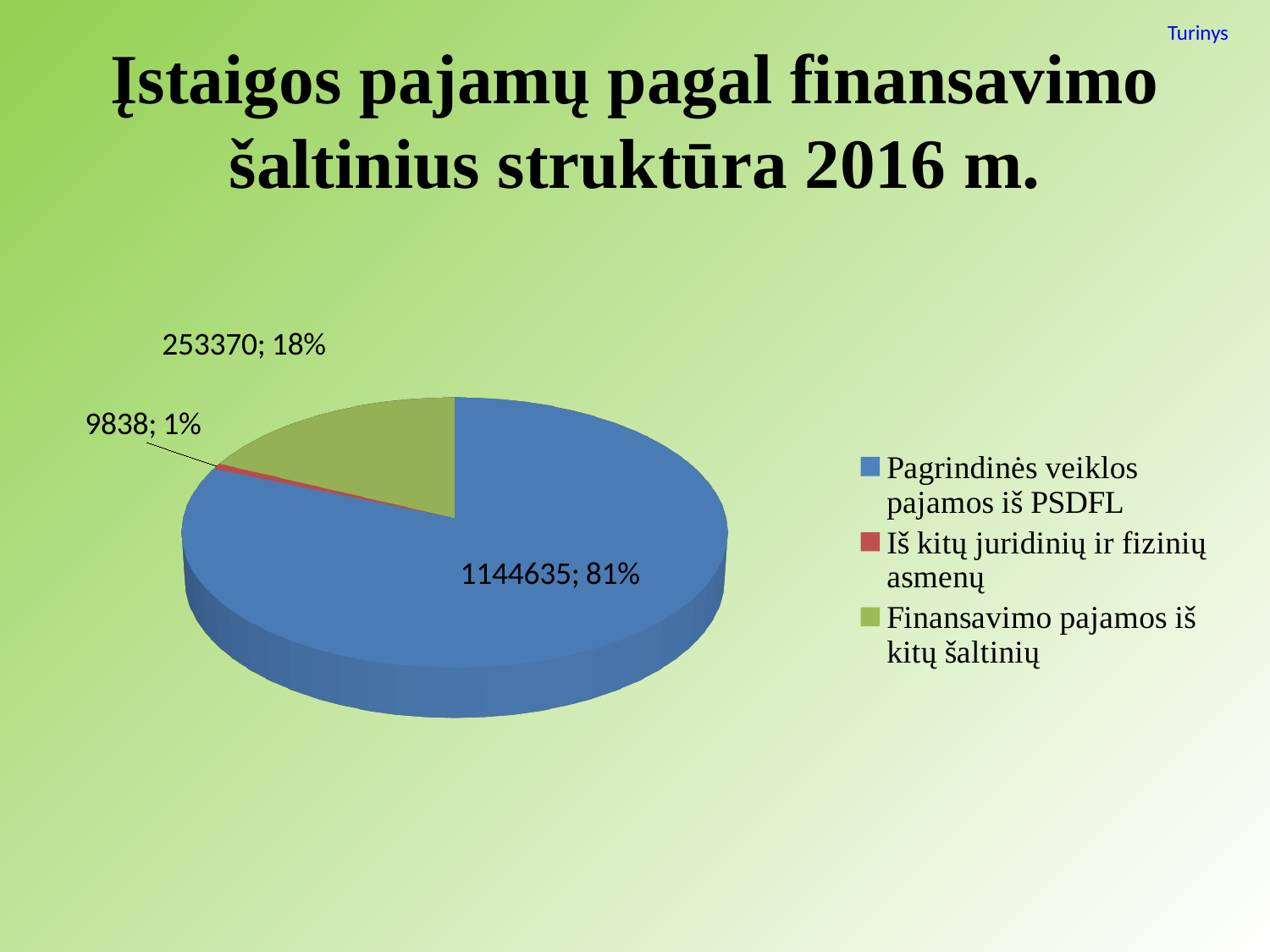
What colour is the slice for Finansavimo pajamos iš kitų šaltinių? green Which category has the smallest slice? Iš kitų juridinių ir fizinių asmenų What is the difference between the values for Finansavimo pajamos iš kitų šaltinių and Iš kitų juridinių ir fizinių asmenų? 243532 Which category has the largest slice? Pagrindinės veiklos pajamos iš PSDFL How many categories does the pie chart have? 3 Which is larger: Finansavimo pajamos iš kitų šaltinių or Iš kitų juridinių ir fizinių asmenų? Finansavimo pajamos iš kitų šaltinių What is the value for Iš kitų juridinių ir fizinių asmenų? 9838 What kind of chart is shown on the slide? pie chart What share of the pie does Pagrindinės veiklos pajamos iš PSDFL take? 81% What is the value for Pagrindinės veiklos pajamos iš PSDFL? 1144635 What is the value for Finansavimo pajamos iš kitų šaltinių? 253370 What share of the pie does Finansavimo pajamos iš kitų šaltinių take? 18%